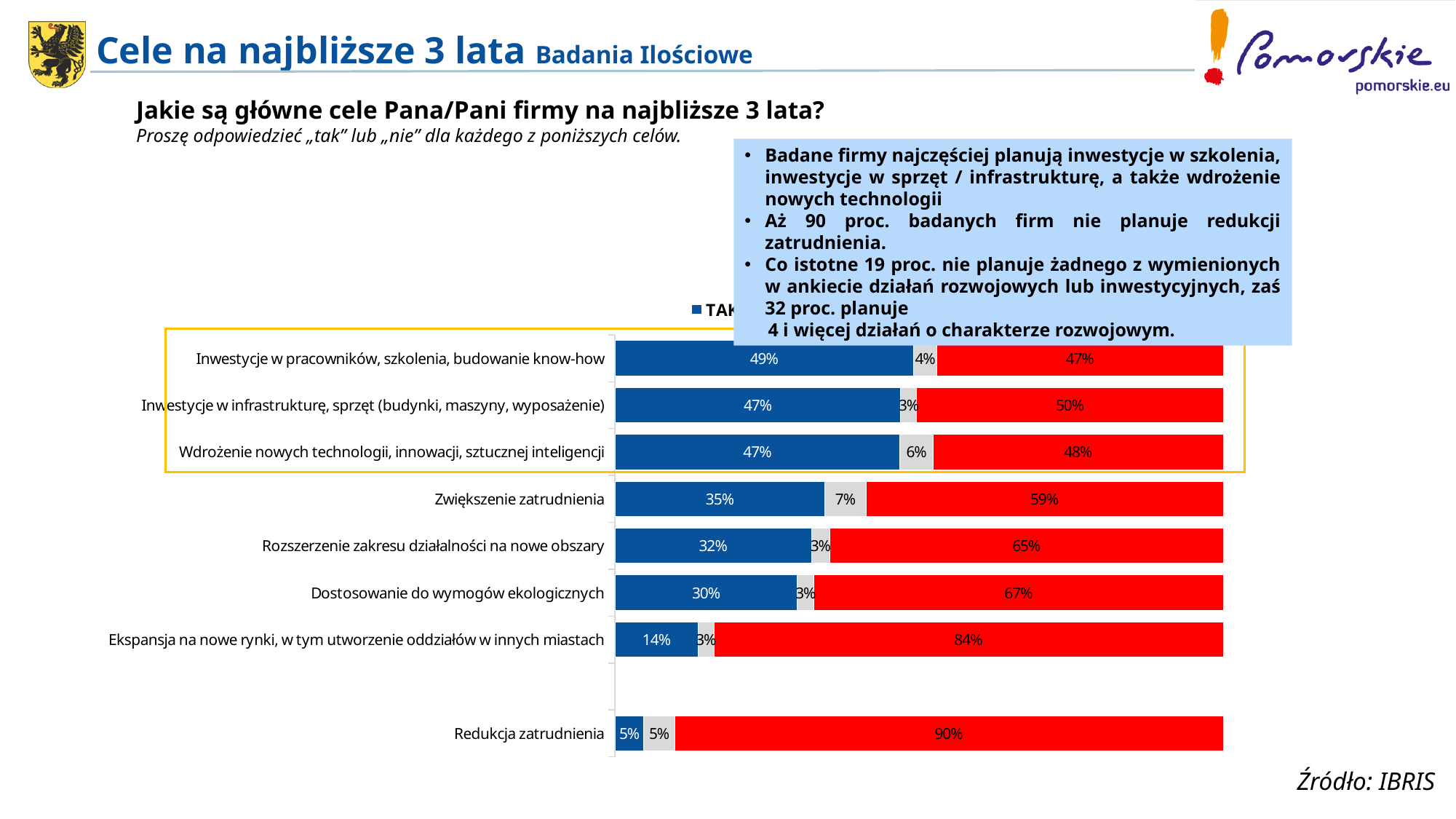
Which category has the highest TAK (blue) value? Inwestycje w pracowników, szkolenia, budowanie know-how Which category has the highest red (NIE) value? Redukcja zatrudnienia How many categories (goals) are shown in the chart? 8 What kind of chart is shown on the slide? Stacked bar chart What is the difference between the red (NIE) value and the TAK (blue) value for "Dostosowanie do wymogów ekologicznych"? 37% What colour are the TAK segments in the chart? Blue What is the total of the three segments for "Redukcja zatrudnienia"? 100% Which category has the lowest TAK (blue) value? Redukcja zatrudnienia Which is larger: the TAK value for "Rozszerzenie zakresu działalności na nowe obszary" or the TAK value for "Ekspansja na nowe rynki, w tym utworzenie oddziałów w innych miastach"? Rozszerzenie zakresu działalności na nowe obszary What is the TAK (blue) value for "Zwiększenie zatrudnienia"? 35% What is the red (NIE) value for "Ekspansja na nowe rynki, w tym utworzenie oddziałów w innych miastach"? 84% What is the grey middle segment value for "Wdrożenie nowych technologii, innowacji, sztucznej inteligencji"? 6%